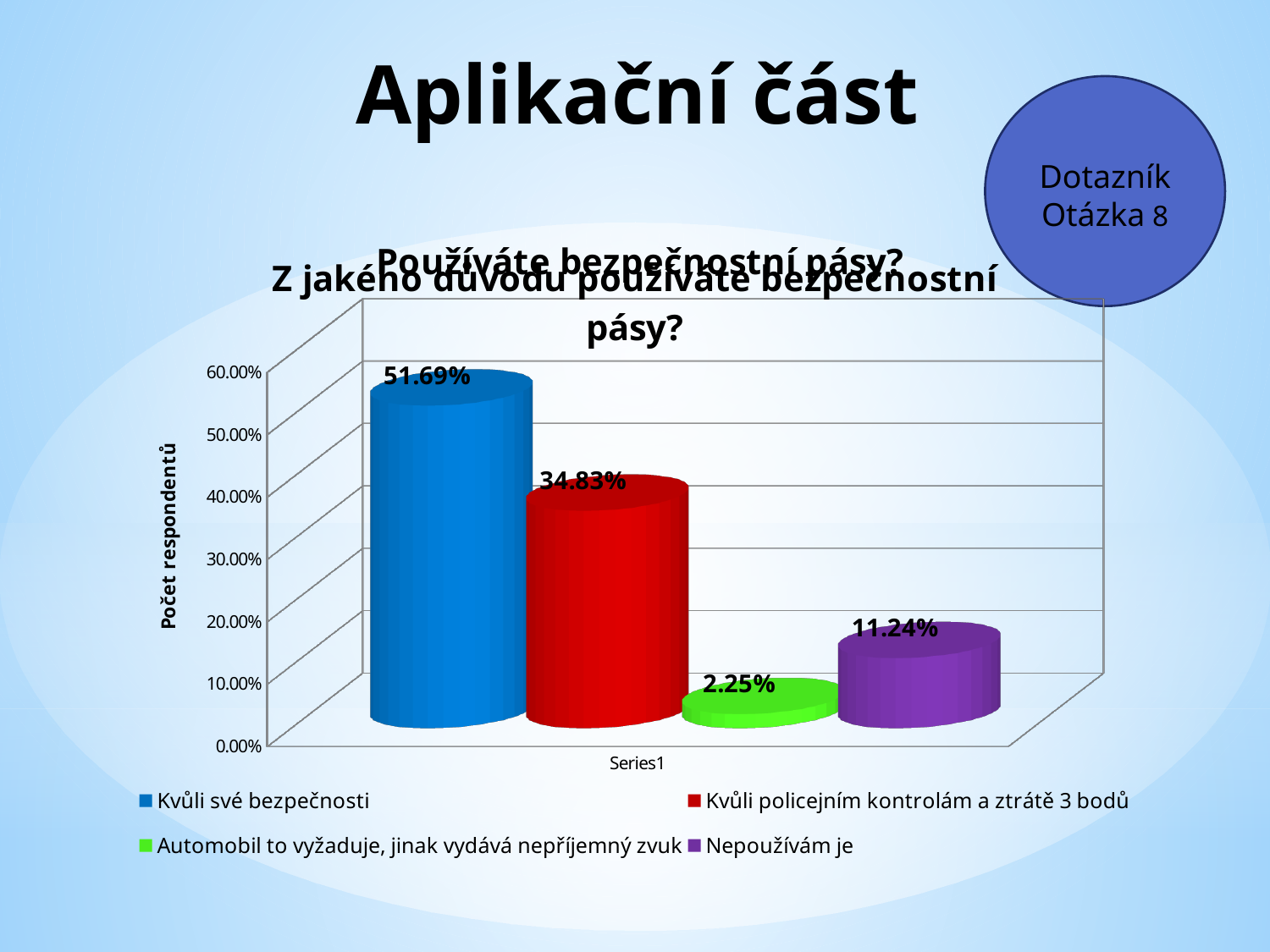
What is the value for "Nepoužívám je"? 11.24% What is the value for "Automobil to vyžaduje, jinak vydává nepříjemný zvuk"? 2.25% Which legend entry has the highest value? Kvůli své bezpečnosti What is the value for "Kvůli své bezpečnosti"? 51.69% Is the value for "Kvůli své bezpečnosti" greater or less than 50.00%? greater Which legend entry has the lowest value? Automobil to vyžaduje, jinak vydává nepříjemný zvuk What is the label of the vertical axis? Počet respondentů What is the value for "Kvůli policejním kontrolám a ztrátě 3 bodů"? 34.83% What kind of chart is shown on the slide? bar chart Which is larger, the value for "Nepoužívám je" or the value for "Automobil to vyžaduje, jinak vydává nepříjemný zvuk"? Nepoužívám je How many series does the legend list? 4 What is the difference between the values for "Kvůli své bezpečnosti" and "Kvůli policejním kontrolám a ztrátě 3 bodů"? 16.86%